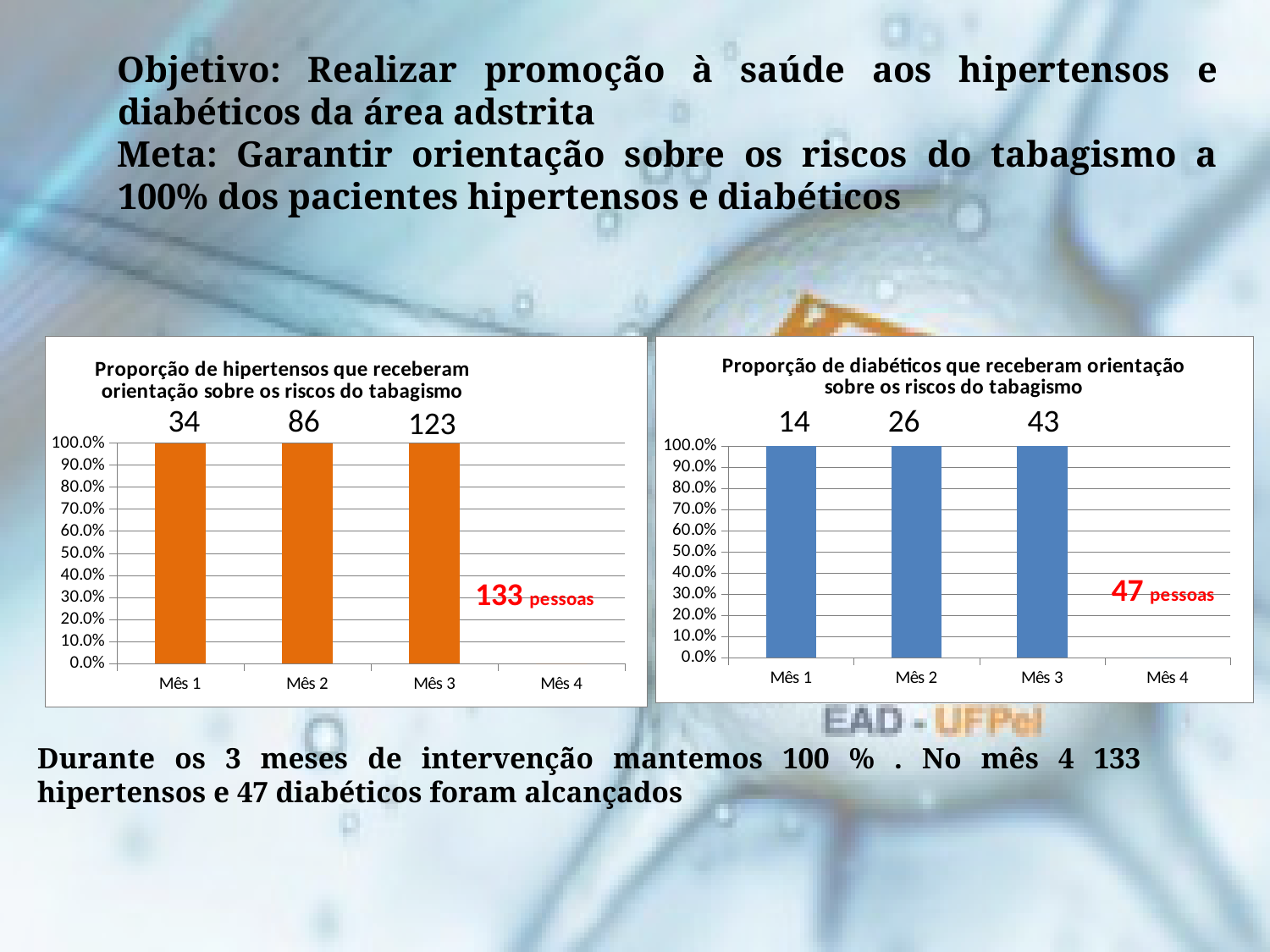
In the right chart (diabéticos), what number is printed above the bar for Mês 1? 14 What kind of chart is the left chart, 'Proporção de hipertensos que receberam orientação sobre os riscos do tabagismo'? Bar chart In the left chart (hipertensos), what is the difference between the numbers printed for Mês 3 and Mês 2? 37 In the left chart (hipertensos), what number is printed above the bar for Mês 3? 123 In the left chart (hipertensos), what percentage does the bar for Mês 1 reach on the y axis? 100.0% In the right chart (diabéticos), what number is printed above the bar for Mês 3? 43 Do the numbers printed above the bars in the left chart (hipertensos) rise or fall from Mês 1 to Mês 3? Rise How many month categories are shown on the x axis of the right chart (diabéticos)? 4 What colour are the bars in the right chart (diabéticos)? Blue In the right chart (diabéticos), what is the difference between the numbers printed for Mês 3 and Mês 2? 17 In the right chart (diabéticos), which month has the highest number printed above its bar? Mês 3 In the left chart (hipertensos), what number is printed above the bar for Mês 2? 86